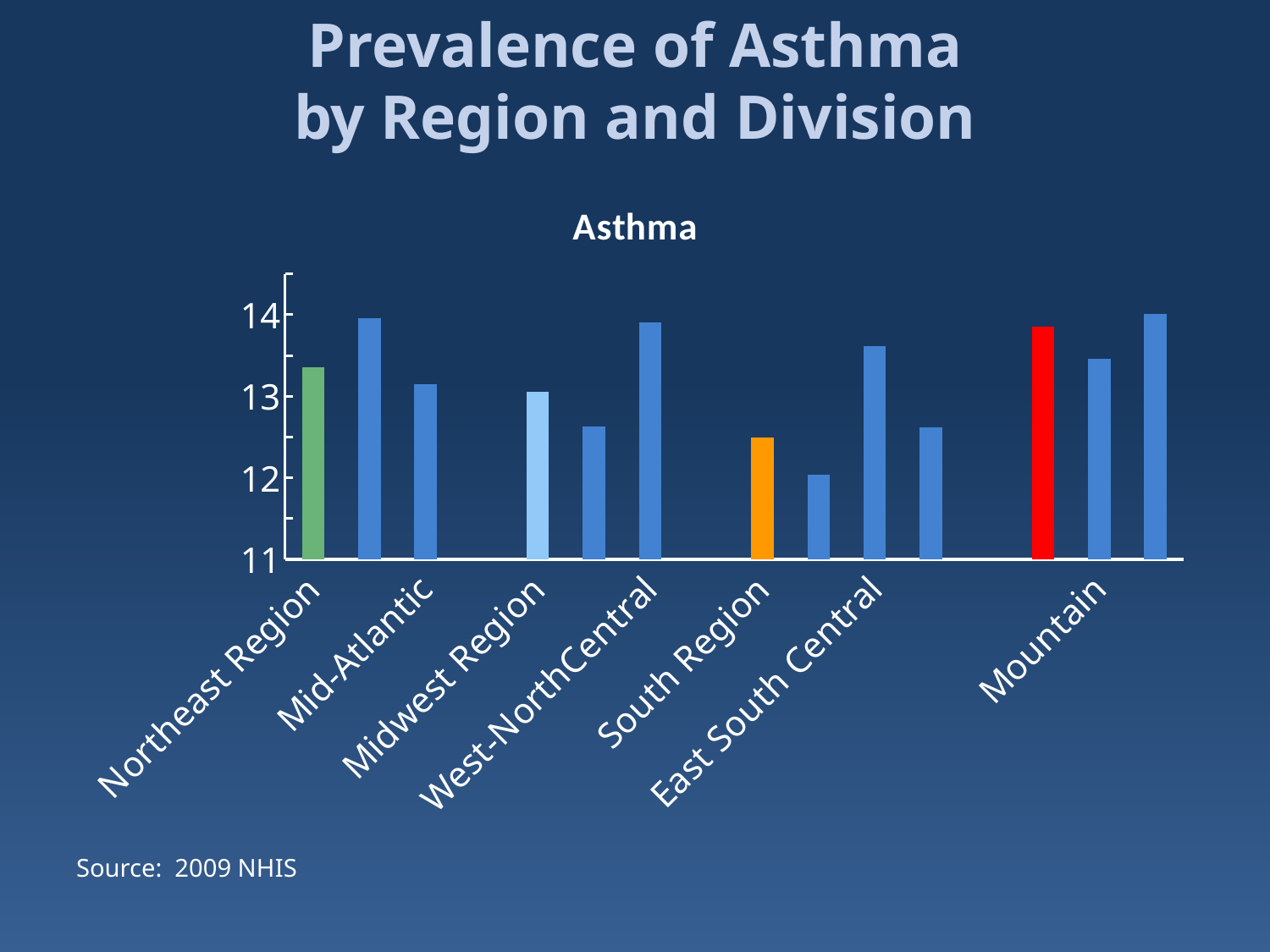
Is the value for Midwest Region greater or less than 14? less What kind of chart is shown on the slide? bar chart Is the value for Mountain greater or less than 13? greater Which is larger, the value for West-NorthCentral or the value for Midwest Region? West-NorthCentral Which is larger, the value for Northeast Region or the value for South Region? Northeast Region Is the value for Northeast Region greater or less than 13? greater Which is larger, the value for East South Central or the value for South Region? East South Central What colour is the bar for South Region? orange What is the title shown above the chart? Asthma